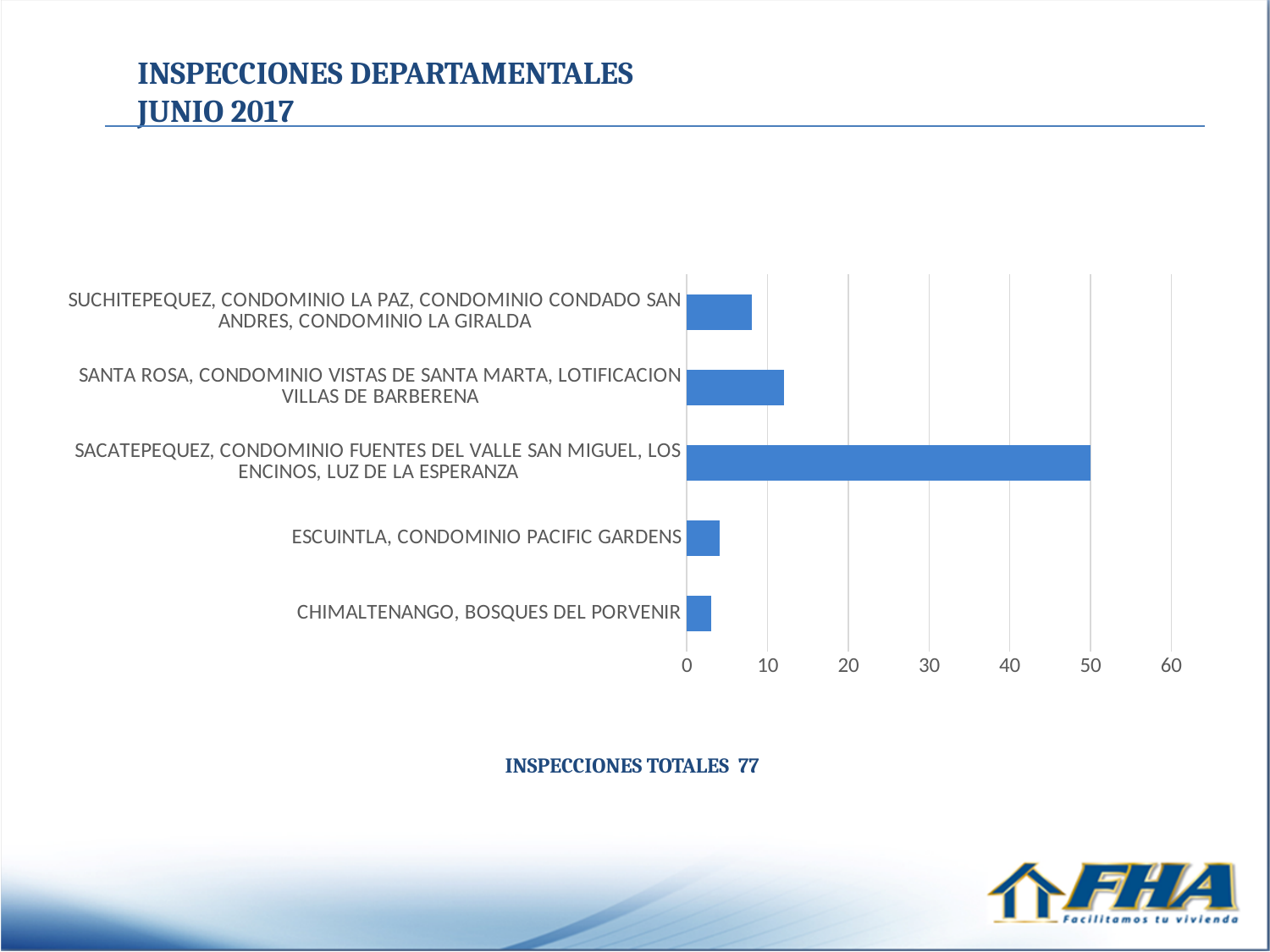
What is the value for SACATEPEQUEZ, CONDOMINIO FUENTES DEL VALLE SAN MIGUEL, LOS ENCINOS, LUZ DE LA ESPERANZA? 50 Which category has the highest value? SACATEPEQUEZ, CONDOMINIO FUENTES DEL VALLE SAN MIGUEL, LOS ENCINOS, LUZ DE LA ESPERANZA What is the maximum value shown on the horizontal axis of the chart? 60 Is the value for SANTA ROSA, CONDOMINIO VISTAS DE SANTA MARTA, LOTIFICACION VILLAS DE BARBERENA greater or less than 10? greater Which is larger, the value for SANTA ROSA, CONDOMINIO VISTAS DE SANTA MARTA, LOTIFICACION VILLAS DE BARBERENA or the value for SUCHITEPEQUEZ, CONDOMINIO LA PAZ, CONDOMINIO CONDADO SAN ANDRES, CONDOMINIO LA GIRALDA? SANTA ROSA, CONDOMINIO VISTAS DE SANTA MARTA, LOTIFICACION VILLAS DE BARBERENA How many categories (bars) does the chart show? 5 What kind of chart is shown on the slide? bar chart Is the value for ESCUINTLA, CONDOMINIO PACIFIC GARDENS greater or less than 10? less Which category has the lowest value? CHIMALTENANGO, BOSQUES DEL PORVENIR Is the value for SUCHITEPEQUEZ, CONDOMINIO LA PAZ, CONDOMINIO CONDADO SAN ANDRES, CONDOMINIO LA GIRALDA greater or less than 10? less What total number of inspections is stated below the chart? 77 Which is larger, the value for ESCUINTLA, CONDOMINIO PACIFIC GARDENS or the value for SACATEPEQUEZ, CONDOMINIO FUENTES DEL VALLE SAN MIGUEL, LOS ENCINOS, LUZ DE LA ESPERANZA? SACATEPEQUEZ, CONDOMINIO FUENTES DEL VALLE SAN MIGUEL, LOS ENCINOS, LUZ DE LA ESPERANZA